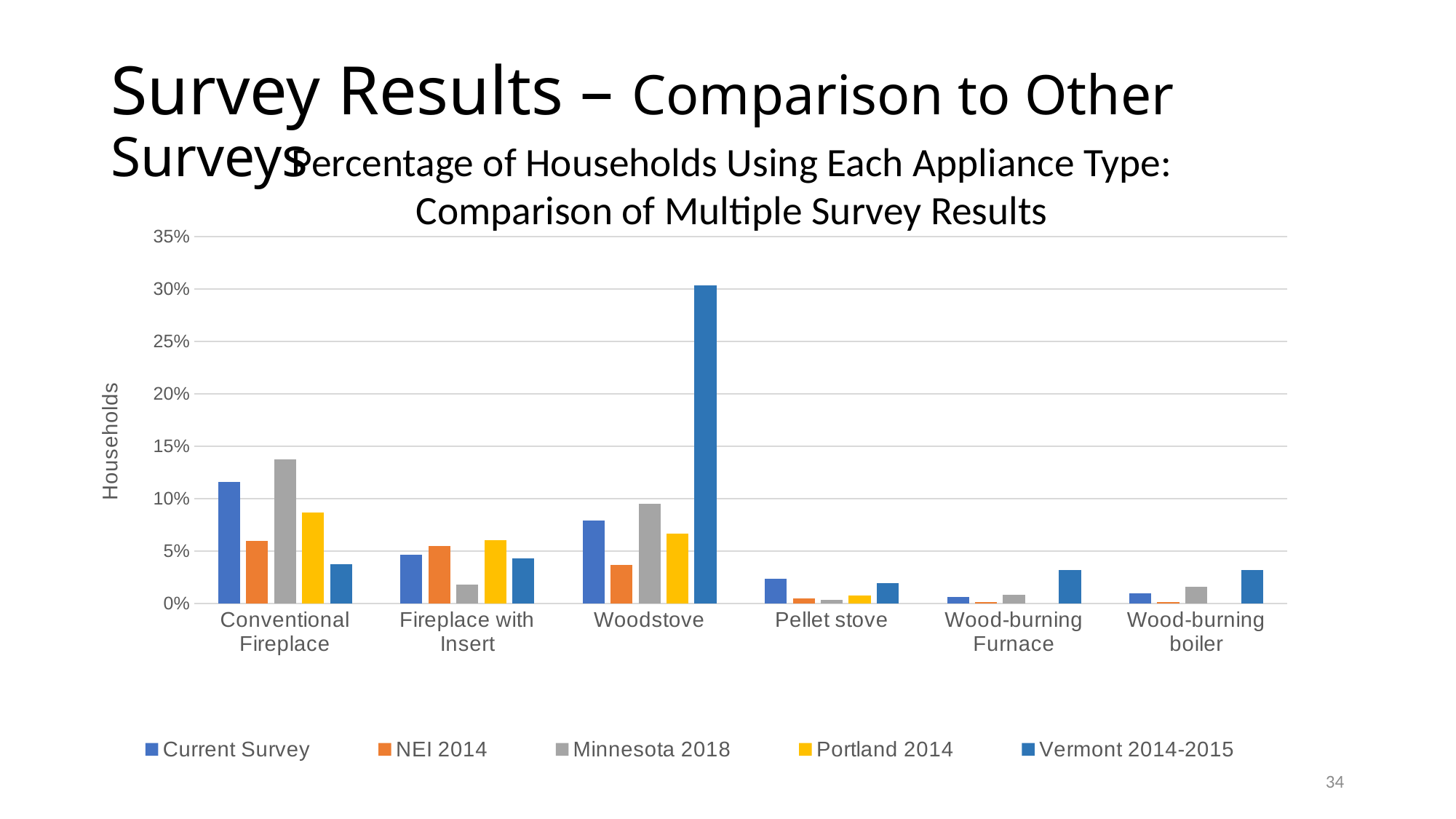
How many series does the legend list? 5 What kind of chart is shown on the slide? Bar chart Is the Vermont 2014-2015 value for Woodstove greater or less than 25%? greater For Conventional Fireplace, which is larger: the Current Survey value or the NEI 2014 value? Current Survey Is the Minnesota 2018 value for Conventional Fireplace greater or less than 10%? greater Which survey has the lowest value for Fireplace with Insert? Minnesota 2018 How many appliance types are shown on the x axis? 6 Which appliance type has the highest value for Vermont 2014-2015? Woodstove What is the label on the y axis of the chart? Households For Woodstove, which is larger: the Minnesota 2018 value or the Portland 2014 value? Minnesota 2018 Is the Current Survey value for Pellet stove greater or less than 5%? less Which survey has the highest value for Conventional Fireplace? Minnesota 2018